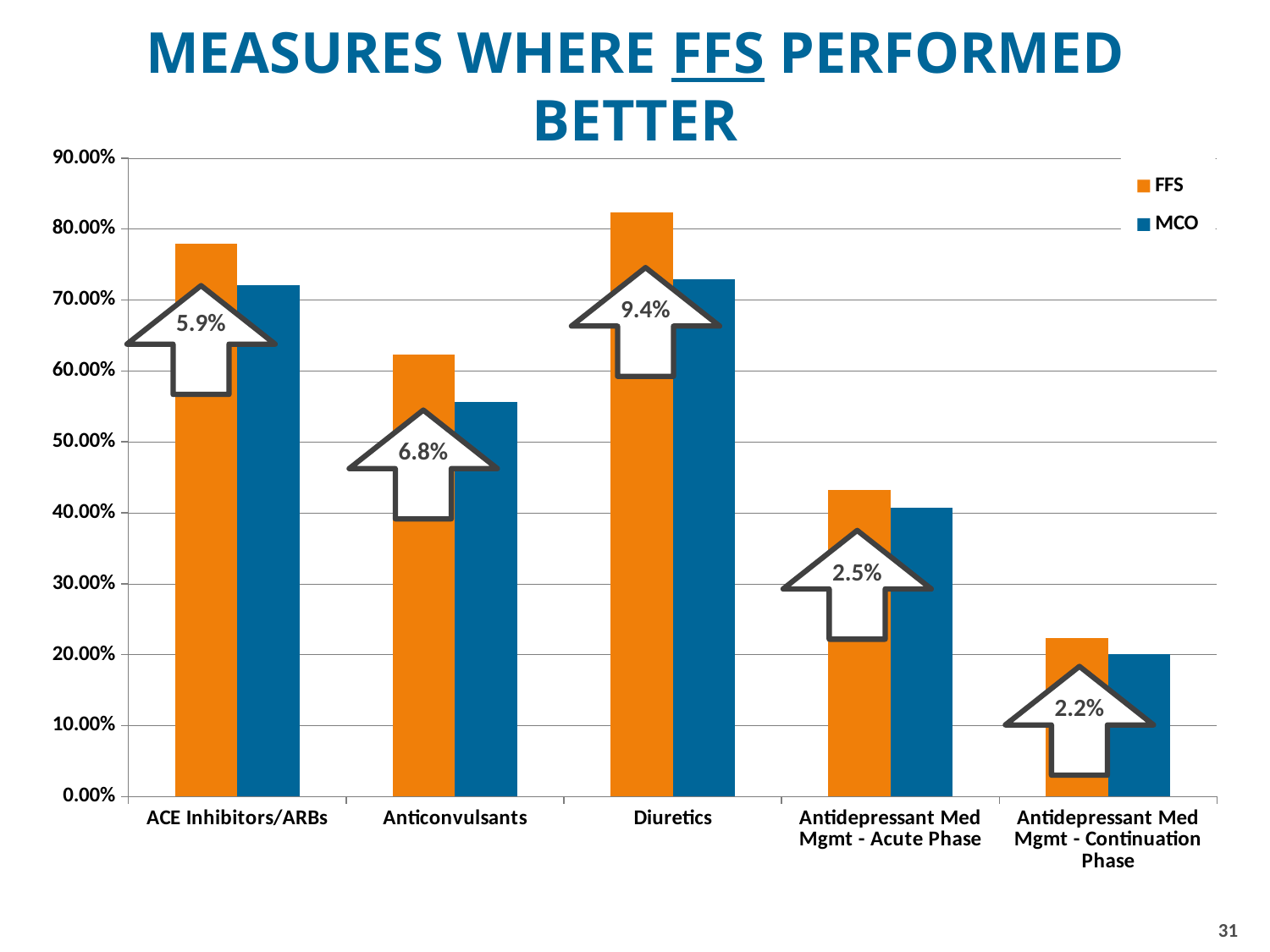
What difference between FFS and MCO is labelled on the arrow for Anticonvulsants? 6.8% What difference between FFS and MCO is labelled on the arrow for Diuretics? 9.4% For ACE Inhibitors/ARBs, which series has the larger value, FFS or MCO? FFS Which measure has the lowest MCO value? Antidepressant Med Mgmt - Continuation Phase How many measure categories are shown on the x axis? 5 What difference between FFS and MCO is labelled on the arrow for Antidepressant Med Mgmt - Acute Phase? 2.5% Is the FFS value for Diuretics greater or less than 80.00%? greater Which colour represents the MCO series in the chart? blue What type of chart is shown on the slide? bar chart Is the MCO value for Anticonvulsants greater or less than 60.00%? less How many series does the legend list? 2 Which measure has the highest FFS value? Diuretics